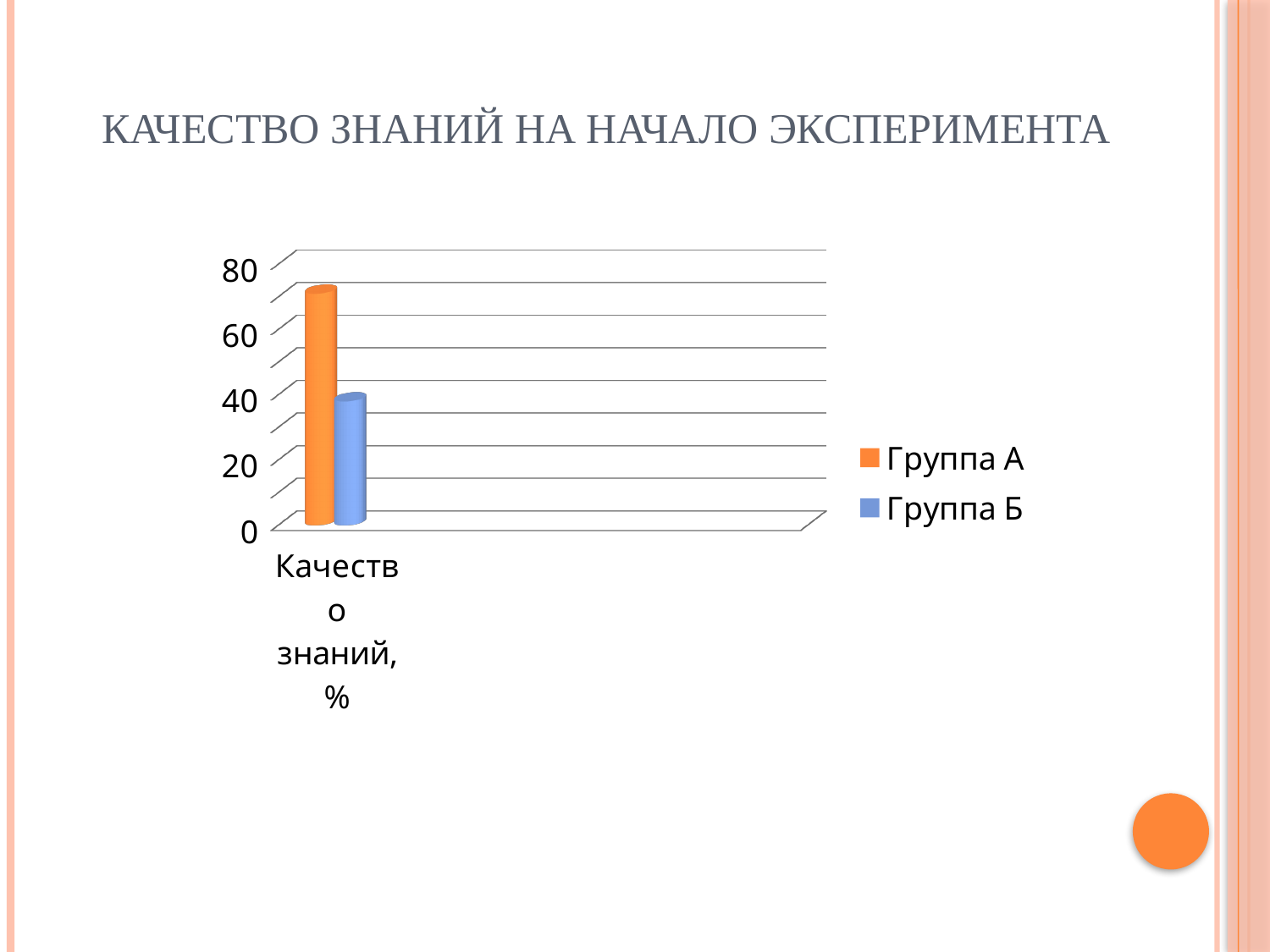
What is the title of the slide containing the chart? Качество знаний на начало эксперимента Which series has the highest value on the chart? Группа А Which series has the lowest value on the chart? Группа Б What kind of chart is shown on the slide? bar chart How many series does the legend list? 2 Is the value for Группа А greater or less than 80? less Is the value for Группа Б greater or less than 20? greater Which series has the higher value for Качество знаний, %: Группа А or Группа Б? Группа А Is the value for Группа Б greater or less than 60? less Which colour represents Группа Б in the legend? blue How many categories are plotted on the x axis? 1